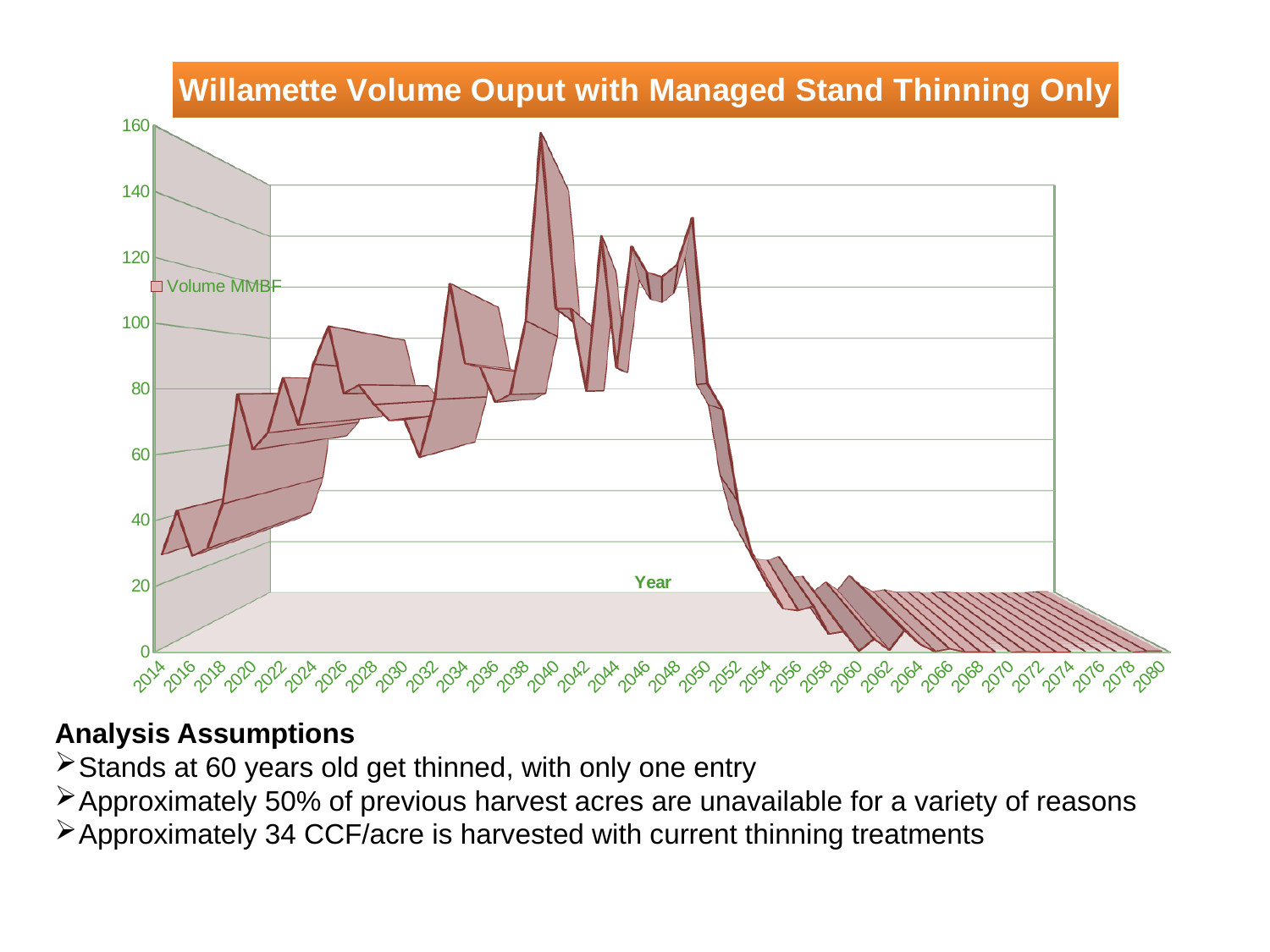
What is the highest value shown on the vertical axis? 160 How many series does the chart's legend list? 1 What kind of chart is shown on the slide? line chart Is the value for 2014 greater or less than 60? less Do the values rise or fall along the x axis from 2050 to 2080? fall What is the title of the chart? Willamette Volume Ouput with Managed Stand Thinning Only Is the value for 2080 greater or less than 20? less Which year has the larger volume, 2040 or 2070? 2040 Is the value for 2070 greater or less than 40? less What is the name of the series shown in the legend? Volume MMBF In which year does the volume reach its highest value? 2039